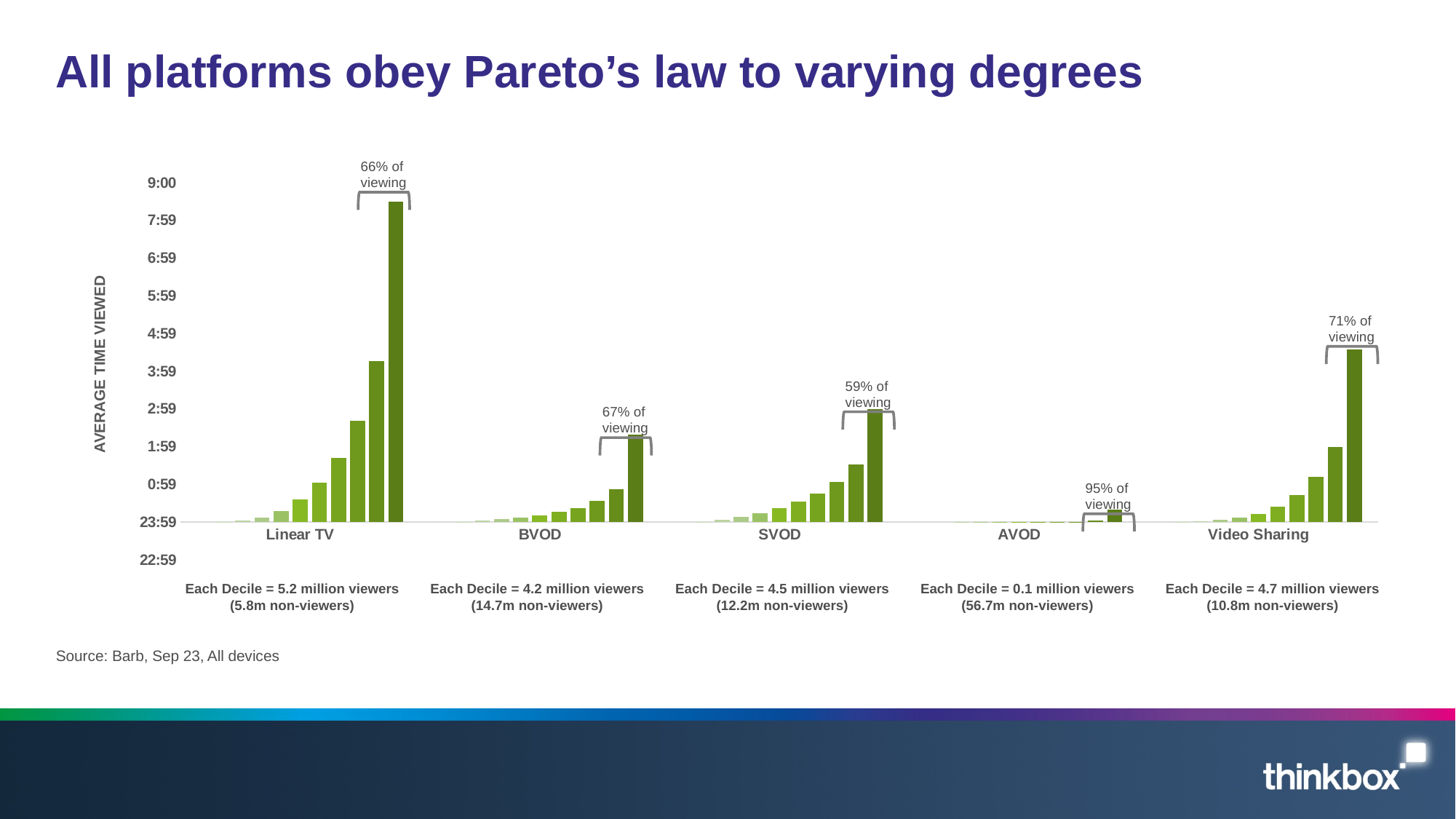
How many viewers does each decile represent for BVOD? 4.2 million viewers Which platform has the tallest top-decile bar in the chart? Linear TV What share of viewing does the top decile account for on Video Sharing? 71% of viewing Is the average time viewed for the top decile of Linear TV greater or less than 7:59? greater How many platform categories are shown along the x axis of the chart? 5 Which has a higher top-decile share of viewing, BVOD or SVOD? BVOD What kind of chart is shown on the slide? Bar chart What share of viewing does the top decile account for on AVOD? 95% of viewing Is the average time viewed for the top decile of AVOD greater or less than 0:59? less What share of viewing does the top decile account for on Linear TV? 66% of viewing Which platform has the lowest top-decile share of viewing annotated on the chart? SVOD What is the difference in percentage points between the top-decile share of viewing for AVOD and for SVOD? 36 percentage points